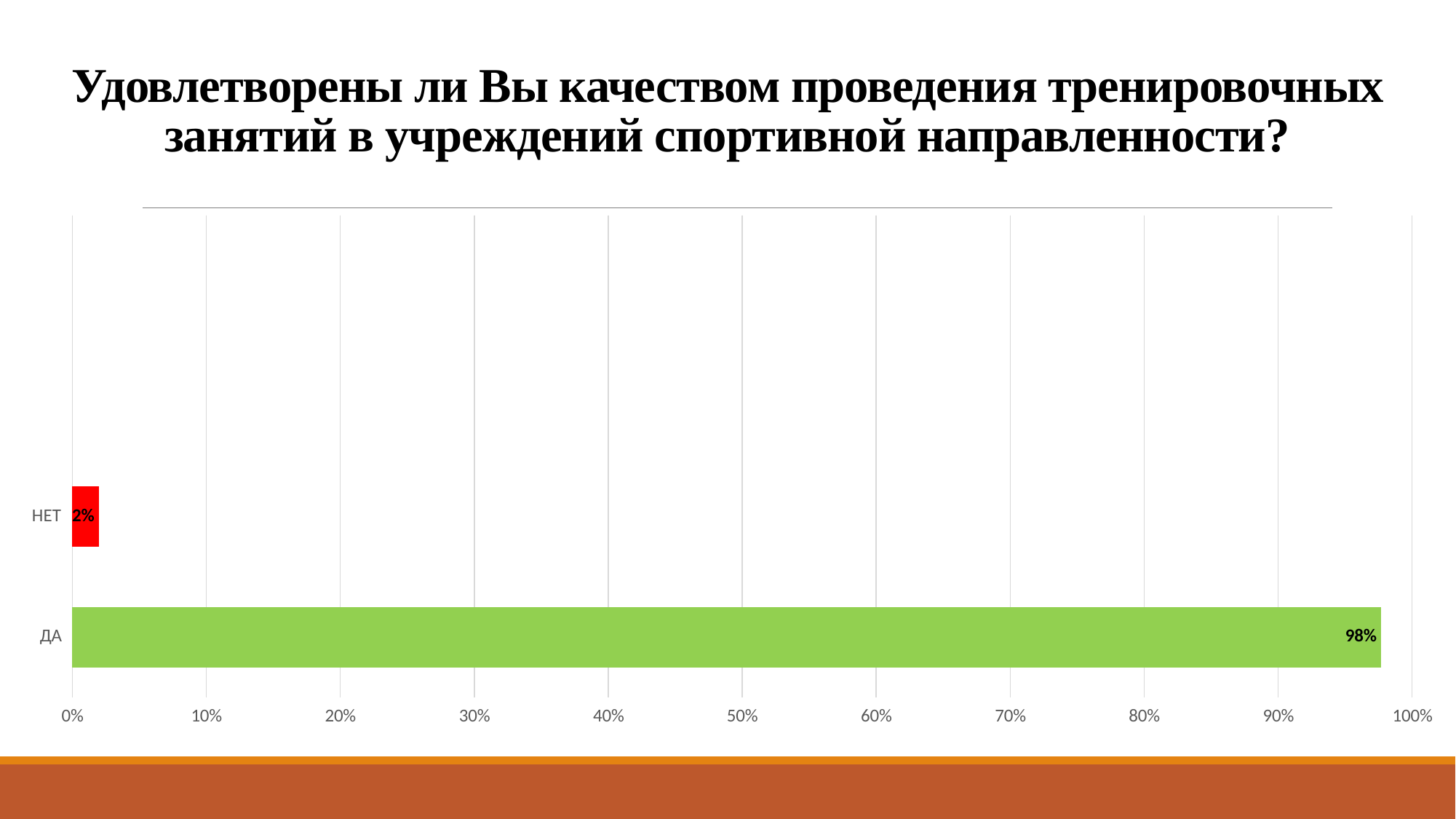
Which is larger, the value for ДА or the value for НЕТ? ДА Is the value for НЕТ greater or less than 10%? less What is the difference between the values for ДА and НЕТ? 96% Which category has the highest value? ДА Is the value for ДА greater or less than 90%? greater Which category has the lowest value? НЕТ What is the value for НЕТ? 2% What is the value for ДА? 98% How many categories are shown in the chart? 2 What colour is the bar for ДА? green What colour is the bar for НЕТ? red What kind of chart is shown on the slide? bar chart